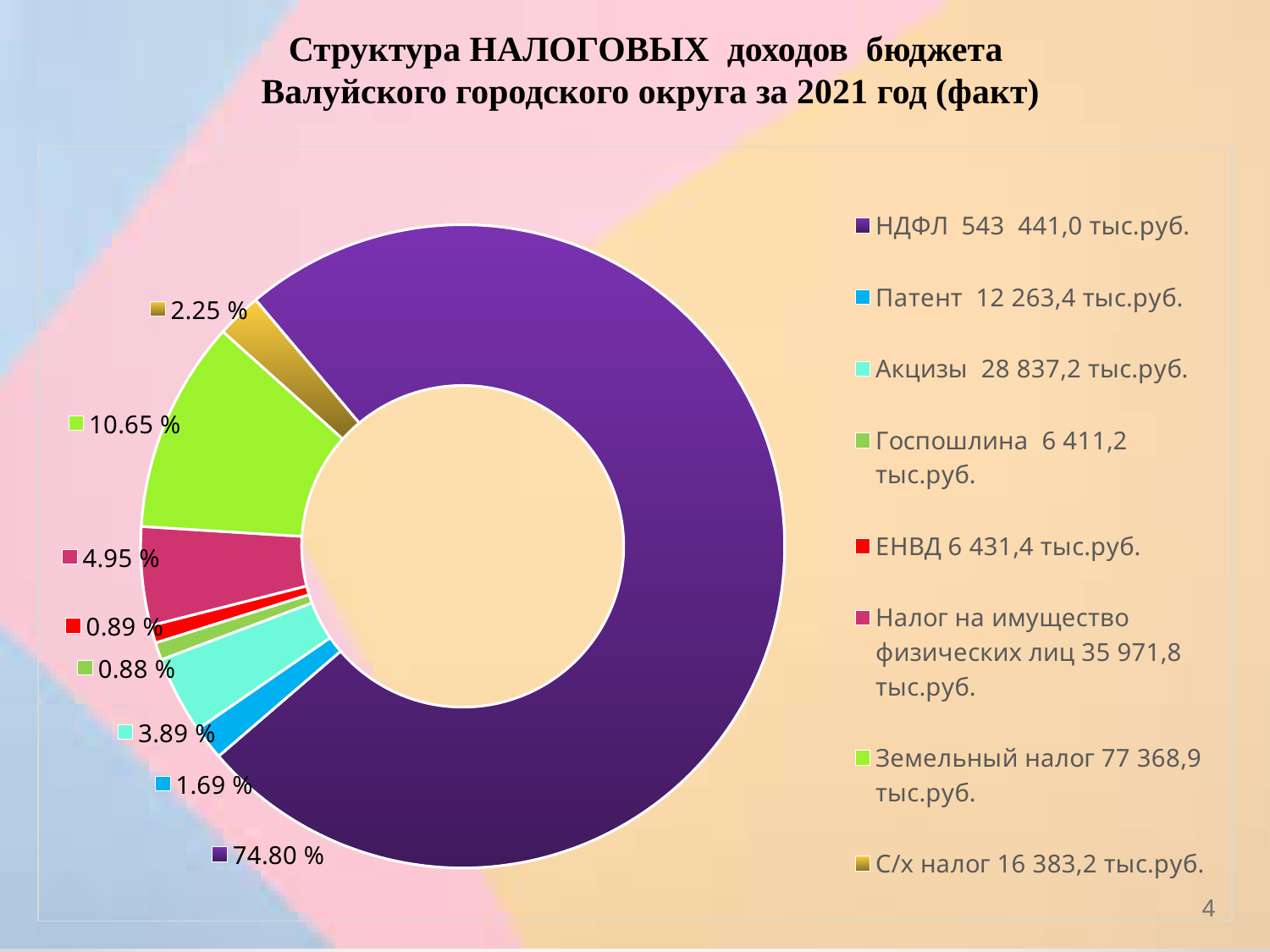
Which category has the largest share of tax revenues? НДФЛ According to the legend, what is the amount of С/х налог revenue? 16 383,2 тыс.руб. What share does Земельный налог account for? 10.65 % How many categories does the chart show? 8 What share does Патент account for? 1.69 % What is the difference in percentage points between the НДФЛ share and the Земельный налог share? 64.15 % What share of tax revenues does НДФЛ account for? 74.80 % What kind of chart is shown on the slide? Pie (doughnut) chart Which has the larger share: Земельный налог or Налог на имущество физических лиц? Земельный налог Which category has the smallest share of tax revenues? Госпошлина (0.88 %) According to the legend, what is the amount of НДФЛ revenue? 543 441,0 тыс.руб.